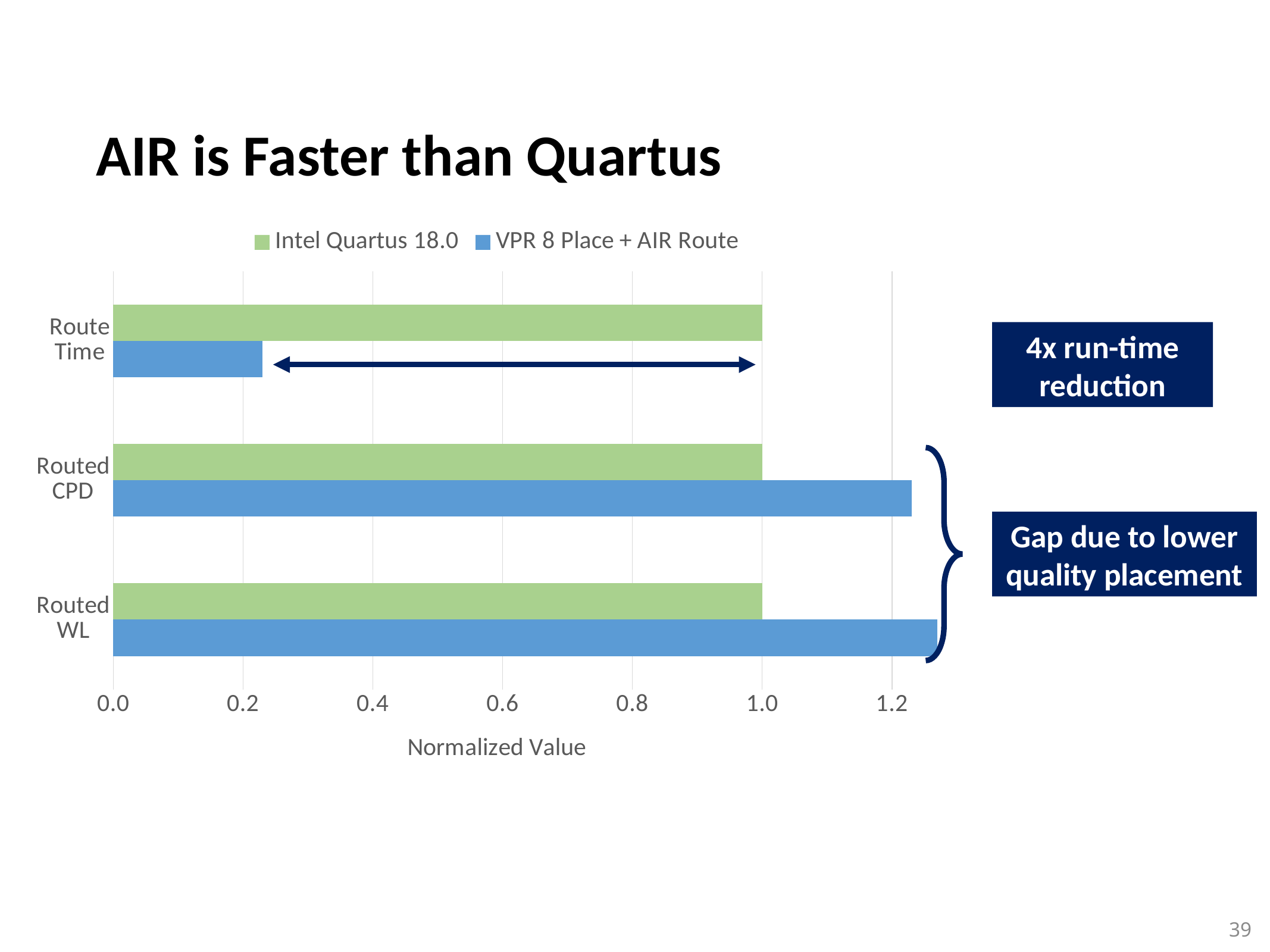
What is the Intel Quartus 18.0 value for Route Time? 1.0 Is the VPR 8 Place + AIR Route value for Routed CPD greater or less than 1.2? greater Is the VPR 8 Place + AIR Route value for Routed WL greater or less than 1.2? greater How many categories are shown on the chart? 3 Is the VPR 8 Place + AIR Route value for Route Time greater or less than 0.4? less What is the label of the x axis? Normalized Value How many series does the legend list? 2 For Route Time, which series has the larger value, Intel Quartus 18.0 or VPR 8 Place + AIR Route? Intel Quartus 18.0 What is the Intel Quartus 18.0 value for Routed CPD? 1.0 Which category has the lowest VPR 8 Place + AIR Route value? Route Time For Routed WL, which series has the larger value, Intel Quartus 18.0 or VPR 8 Place + AIR Route? VPR 8 Place + AIR Route What kind of chart is shown on the slide? bar chart